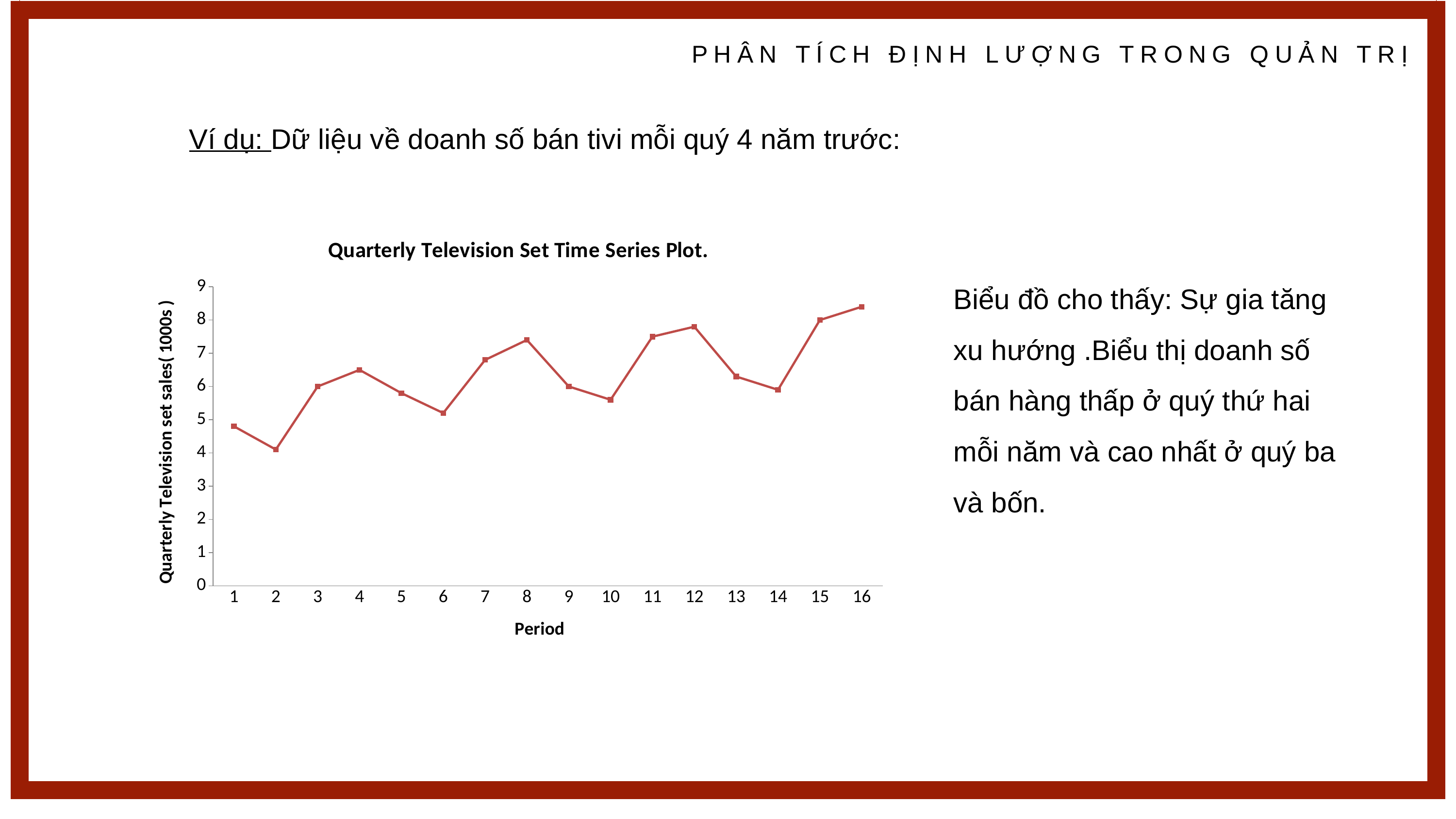
What kind of chart is shown on the slide? line chart Which period has the lowest value in the chart? 2 Is the value for period 16 greater or less than 8? greater What is the title of the chart? Quarterly Television Set Time Series Plot. How many periods are plotted on the x axis of the chart? 16 What is the label of the x axis of the chart? Period Is the value for period 2 greater or less than 5? less Overall, do the values rise or fall from period 1 to period 16? rise Is the value for period 6 greater or less than 5? greater Which has the larger value, period 8 or period 6? period 8 Which period has the highest value in the chart? 16